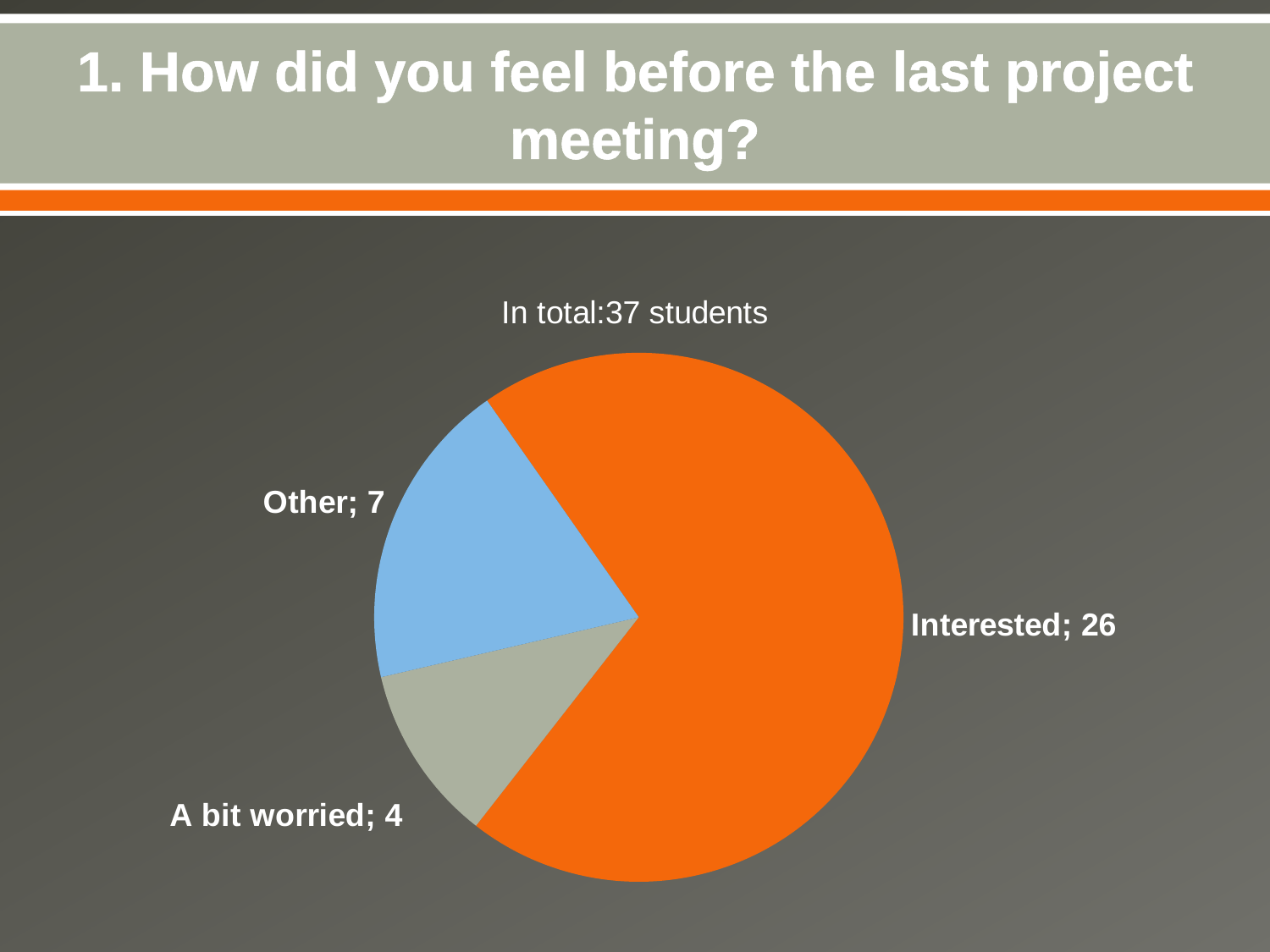
Which response has the smallest slice of the pie? A bit worried What is the difference between the "Other" and "A bit worried" counts? 3 What is the total number of students shown in the chart? 37 How many students answered "Interested"? 26 Which is larger, the "Other" slice or the "A bit worried" slice? Other What kind of chart is shown on the slide? pie chart How many more students answered "Interested" than "Other"? 19 How many students answered "Other"? 7 Which response has the largest slice of the pie? Interested How many slices does the pie chart have? 3 What colour is the "Interested" slice? orange How many students answered "A bit worried"? 4